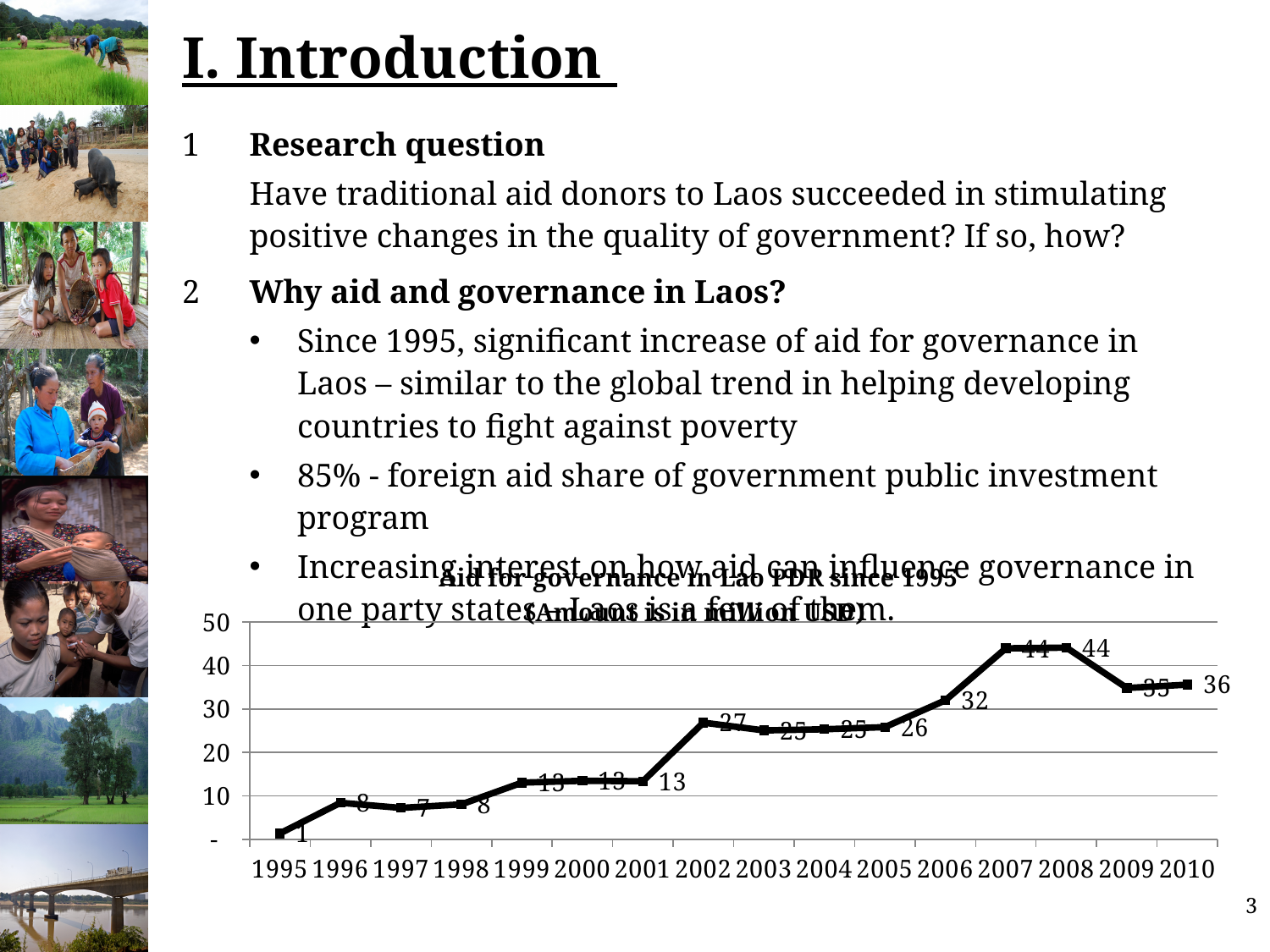
Which is larger, the value for 2002 or the value for 2003? 2002 How many years are plotted on the x axis? 16 What is the value for 2006? 32 What is the difference between the values for 2007 and 2009? 9 Is the value for 2008 greater or less than 40? greater What type of chart is shown on the slide? line chart Does the value rise or fall from 2008 to 2009? fall What is the value for 2010? 36 What is the highest value shown on the chart? 44 Which year has the lowest value? 1995 What is the value for 1995? 1 What is the value for 2002? 27